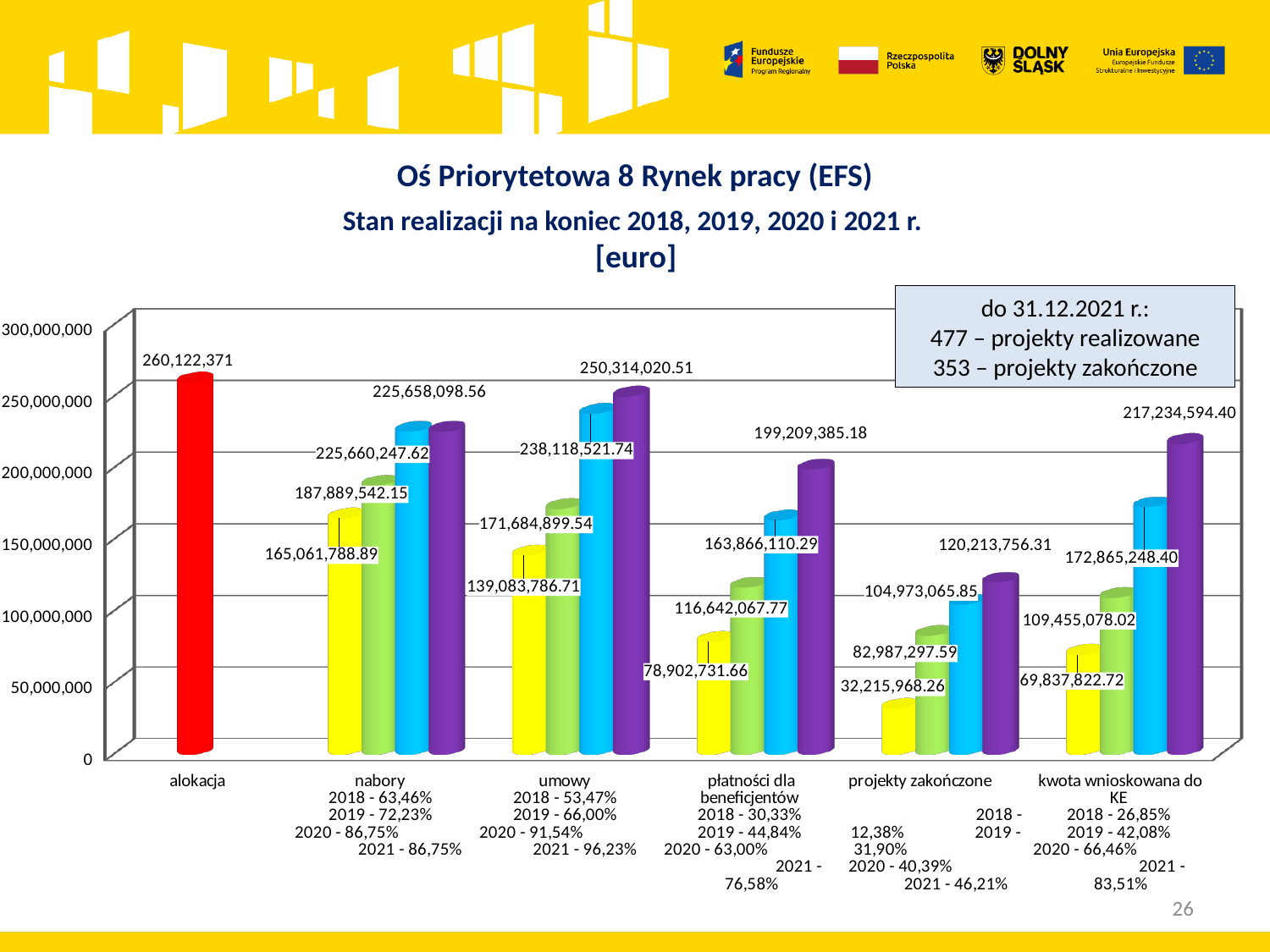
What is the difference between the highest and lowest values in the płatności dla beneficjentów group? 120,306,653.52 Which category contains the tallest bar on the chart? alokacja What is the lowest value labeled in the projekty zakończone group? 32,215,968.26 What is the highest value labeled in the umowy group? 250,314,020.51 Which category contains the shortest bar on the chart? projekty zakończone What kind of chart is shown on the slide? bar chart What is the value of the tallest bar in the kwota wnioskowana do KE group? 217,234,594.40 Is the tallest bar in the projekty zakończone group greater or less than 150,000,000? less Within the kwota wnioskowana do KE group, do the bars rise or fall from left to right? rise What is the value of the alokacja bar? 260,122,371 How many categories are shown on the x axis? 6 What is the difference between the alokacja value and the highest value in the umowy group? 9,808,350.49